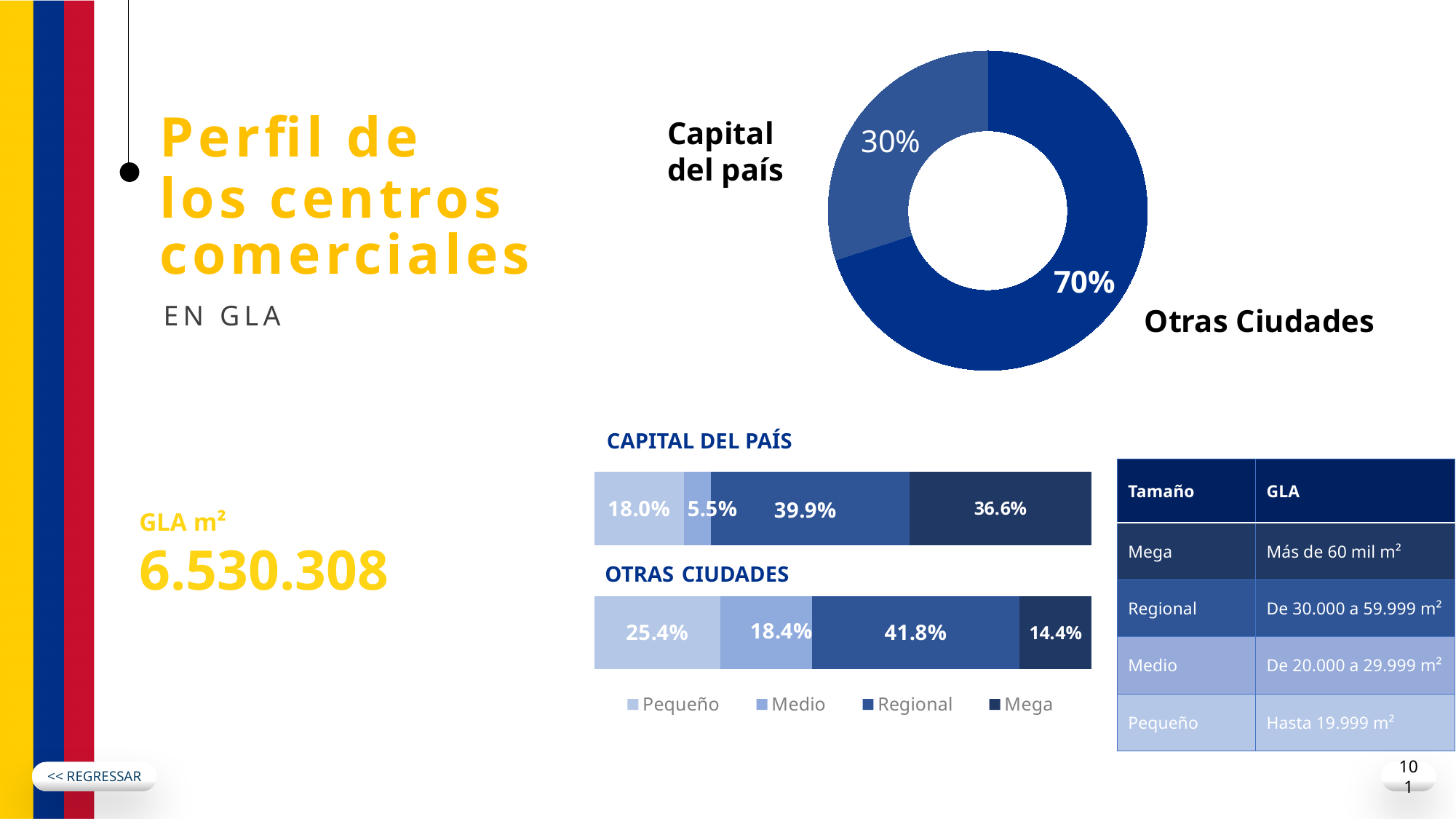
In the OTRAS CIUDADES stacked bar, which segment is the largest? Regional In the donut chart at the top, what share is labelled for Otras Ciudades? 70% In the CAPITAL DEL PAÍS stacked bar, what is the value for Regional? 39.9% In the CAPITAL DEL PAÍS stacked bar, which segment is the smallest? Medio What kind of chart is the one at the top showing Capital del país and Otras Ciudades? Donut chart In the OTRAS CIUDADES stacked bar, what is the value for Mega? 14.4% In the donut chart at the top, which segment is larger, Capital del país or Otras Ciudades? Otras Ciudades In the CAPITAL DEL PAÍS stacked bar, what is the value for Medio? 5.5% In the donut chart at the top, what share is labelled for Capital del país? 30% What is the difference between the Pequeño value in the OTRAS CIUDADES bar and the Pequeño value in the CAPITAL DEL PAÍS bar? 7.4% Which segment is larger, Mega in the CAPITAL DEL PAÍS bar or Mega in the OTRAS CIUDADES bar? CAPITAL DEL PAÍS How many series does the legend below the stacked bars list? 4